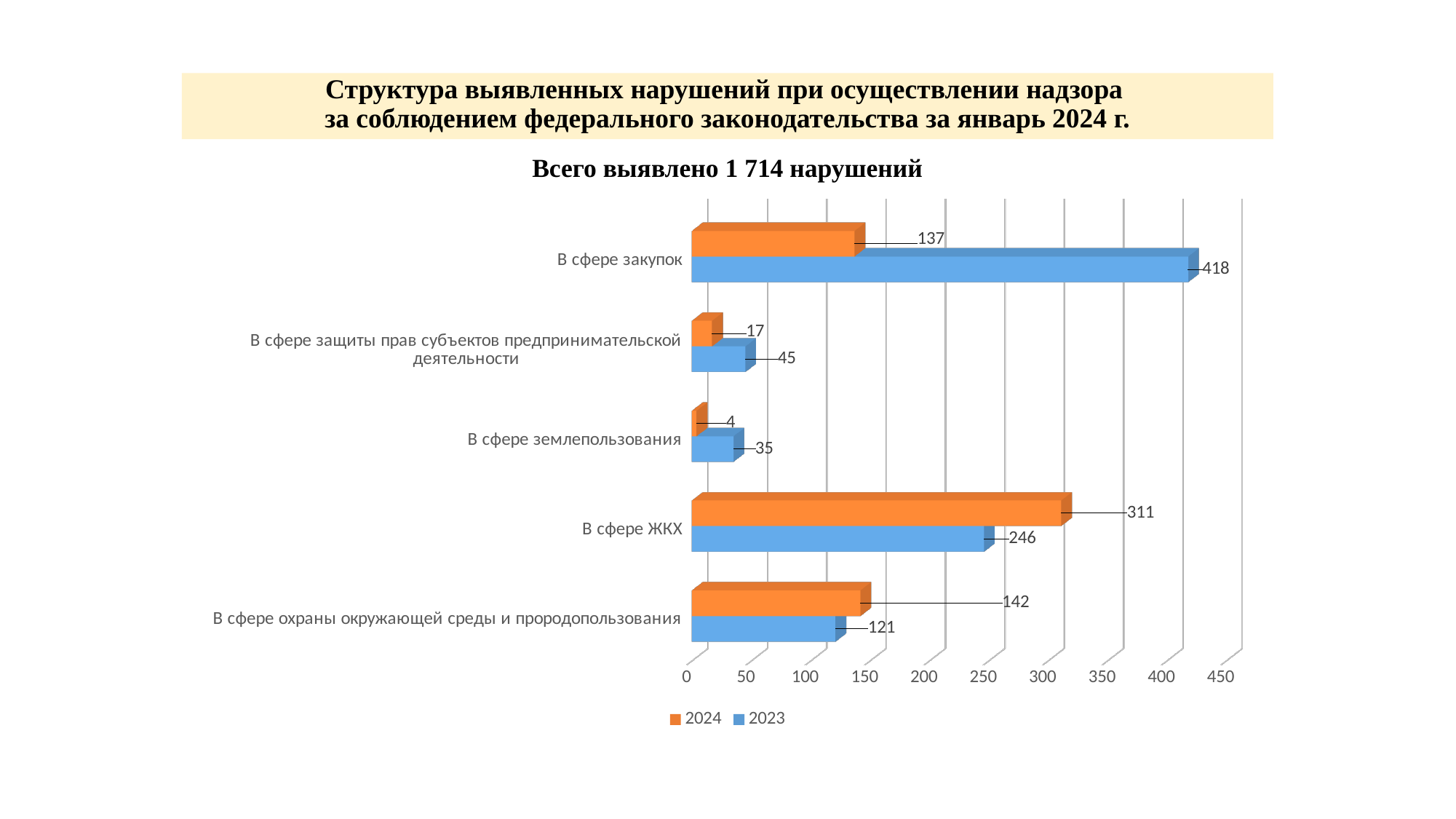
How many categories are shown on the chart? 5 Which category has the lowest 2024 value? В сфере землепользования Which colour represents the 2024 series? Orange What kind of chart is shown on the slide? Bar chart What is the difference between the 2023 and 2024 values for «В сфере закупок»? 281 Which category has the highest 2023 value? В сфере закупок What is the 2024 value for «В сфере охраны окружающей среды и прородопользования»? 142 How many series does the legend list? 2 What is the 2023 value for «В сфере ЖКХ»? 246 Which is larger for «В сфере ЖКХ»: the 2024 value or the 2023 value? 2024 What is the 2024 value for «В сфере закупок»? 137 What is the 2023 value for «В сфере землепользования»? 35